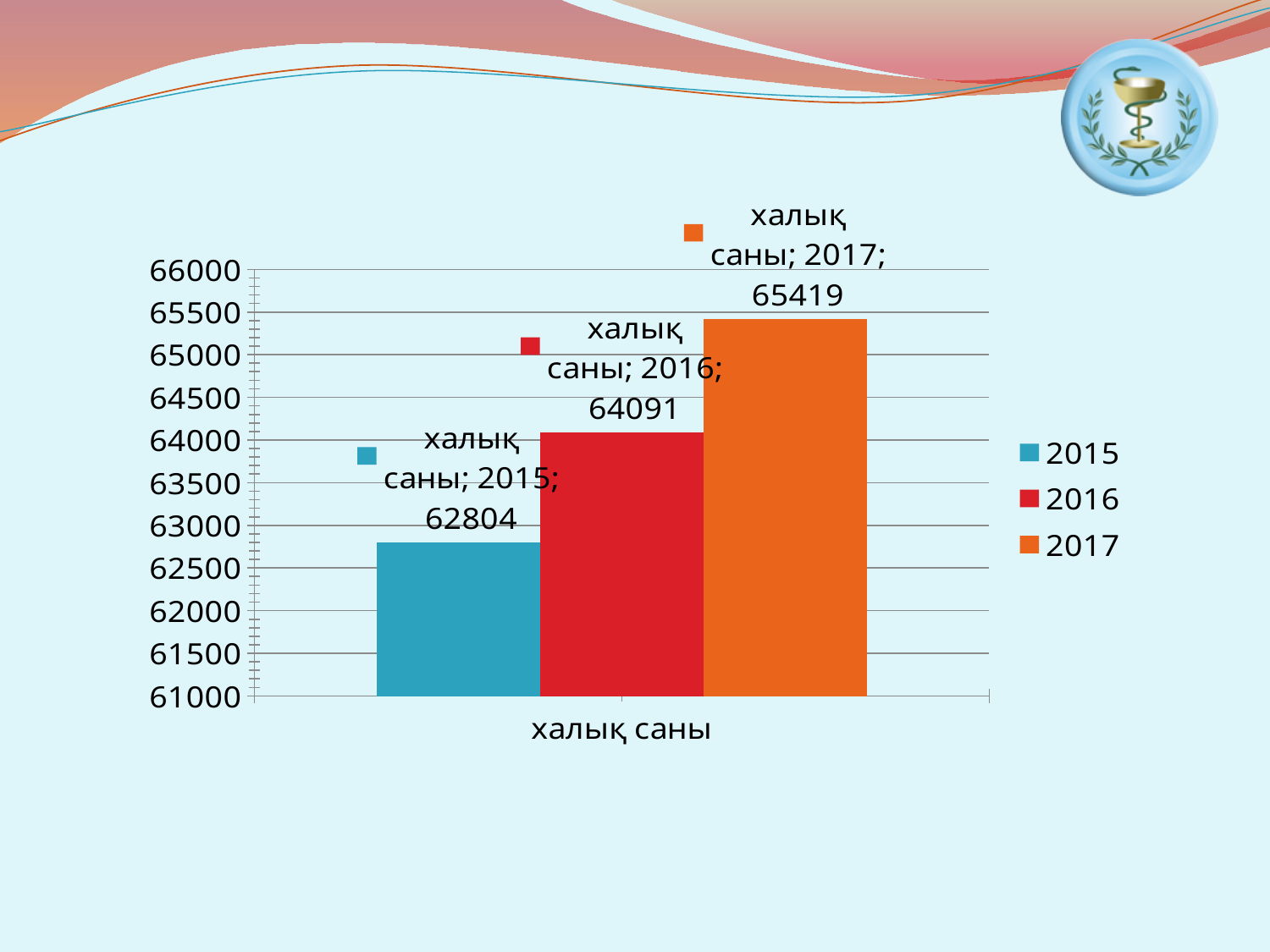
What is the difference between the 2016 and 2015 values? 1287 What is the difference between the 2017 and 2015 values? 2615 Which year has the lowest value in the chart? 2015 Is the value for 2015 greater or less than 63000? less What is the value for 2016 in the chart? 64091 What kind of chart is shown on the slide? bar chart How many series does the legend list? 3 What is the value for 2017 in the chart? 65419 Which year has the highest value in the chart? 2017 What is the category label shown on the x axis of the chart? халық саны What is the value for 2015 in the chart? 62804 Which is larger, the value for 2016 or the value for 2017? 2017